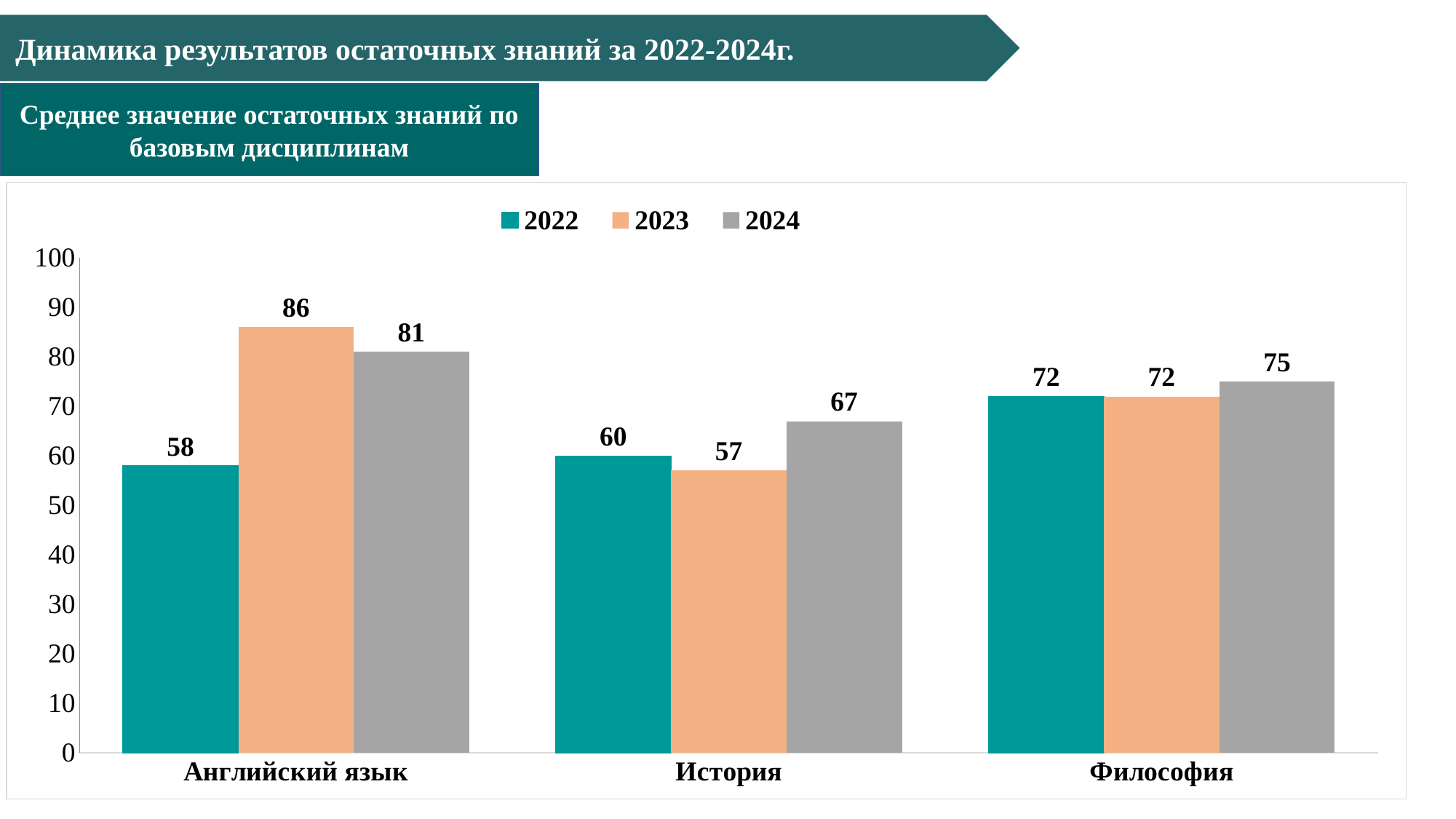
What is the value for История in 2024? 67 Which colour represents the 2024 series in the legend? grey Is the 2024 value for Философия greater or less than 70? greater What is the difference between the 2023 and 2022 values for Английский язык? 28 What is the value for Английский язык in 2023? 86 How many categories are shown on the x axis? 3 What is the value for Философия in 2022? 72 Which is larger for История: the 2022 value or the 2023 value? 2022 What kind of chart is shown on the slide? bar chart How many series does the legend list? 3 Which category has the lowest value in the 2022 series? Английский язык Which category has the highest value in the 2023 series? Английский язык